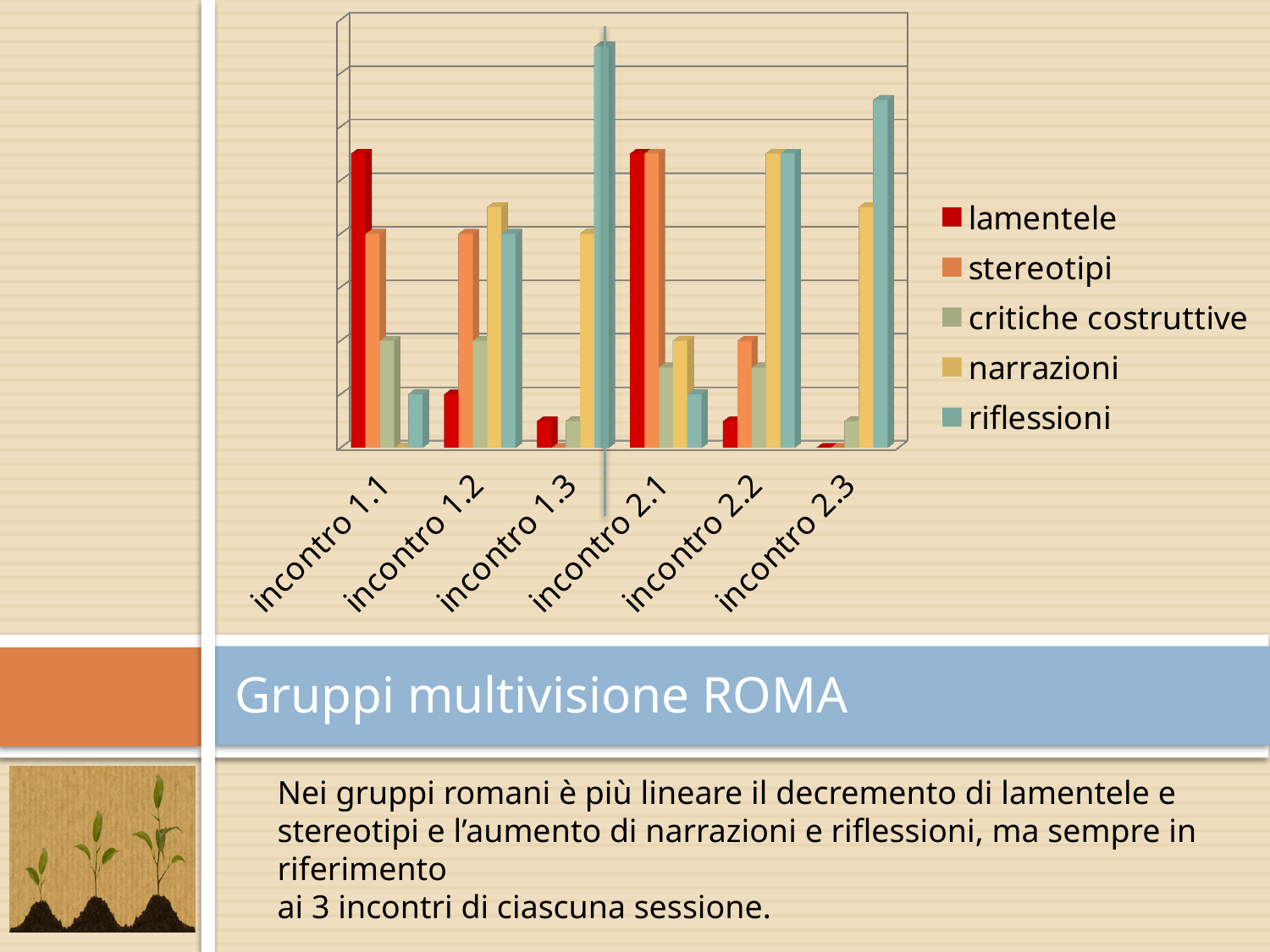
Does the lamentele series rise or fall from incontro 1.1 to incontro 1.3? fall Which series has the tallest bar for incontro 1.3? riflessioni Which colour represents the lamentele series in the legend? red Does the riflessioni series rise or fall from incontro 2.1 to incontro 2.3? rise Which series has the shortest bar for incontro 1.1? narrazioni What kind of chart is shown on the slide? bar chart Which series has the tallest bar for incontro 2.3? riflessioni How many categories (incontri) are shown on the x axis of the chart? 6 Which series has the tallest bar for incontro 1.1? lamentele For incontro 1.1, which is larger: stereotipi or critiche costruttive? stereotipi Which series has the shortest bar for incontro 2.3? lamentele and stereotipi (tied, both 0) How many series does the chart's legend list? 5